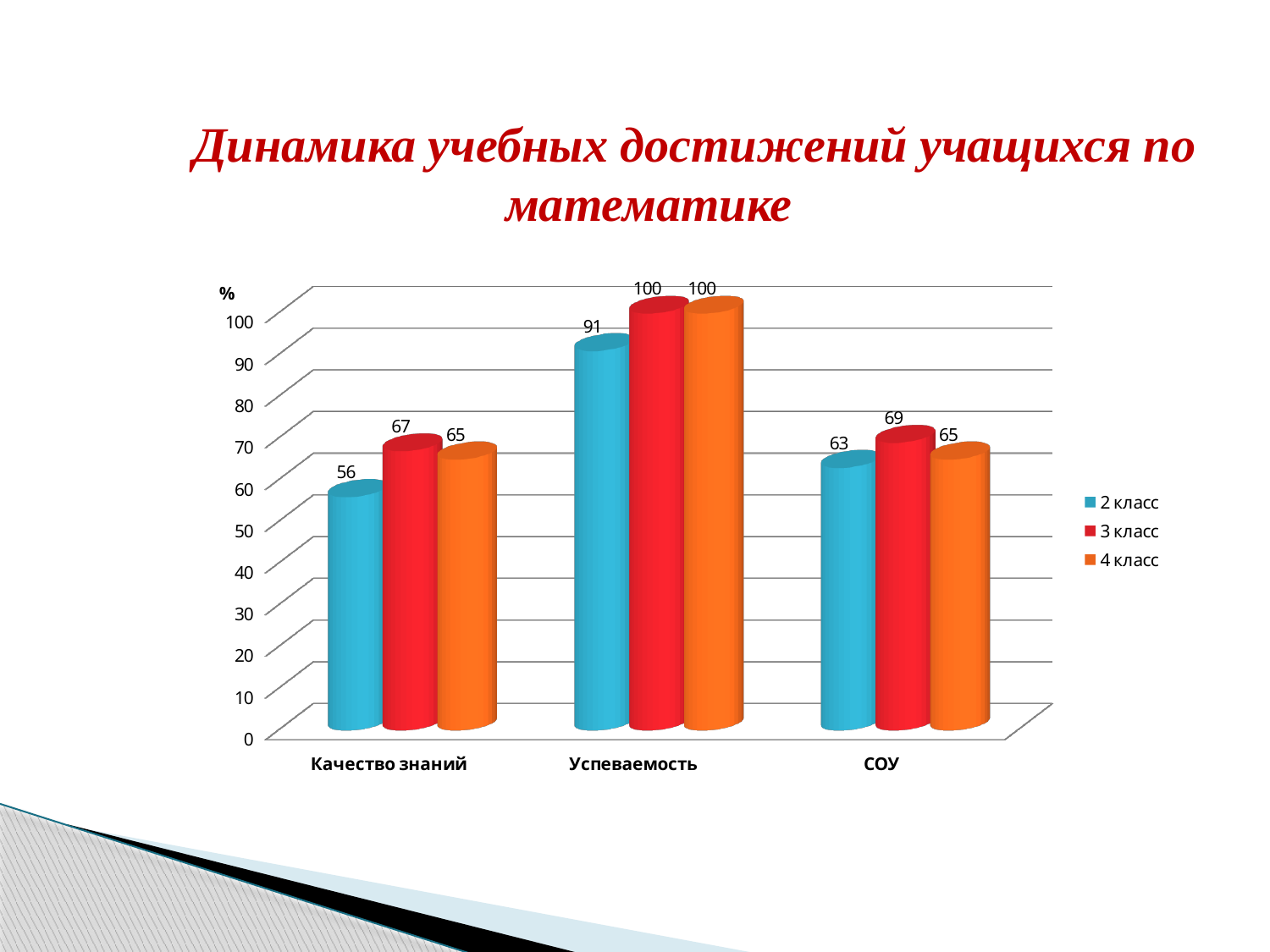
Which series has the lowest value in the Успеваемость category? 2 класс How many series does the legend list? 3 What kind of chart is shown on the slide? Bar chart Is the value for 2 класс in the Успеваемость category greater or less than 80? greater What is the title of the slide? Динамика учебных достижений учащихся по математике Which is larger: the 4 класс value for Качество знаний or the 4 класс value for СОУ? They are equal (65) What is the difference between the 3 класс and 2 класс values in the Качество знаний category? 11 Which series has the highest value in the Качество знаний category? 3 класс What is the value for 4 класс in the Успеваемость category? 100 What is the value for 2 класс in the Качество знаний category? 56 What is the value for 3 класс in the СОУ category? 69 How many categories are shown on the x axis? 3